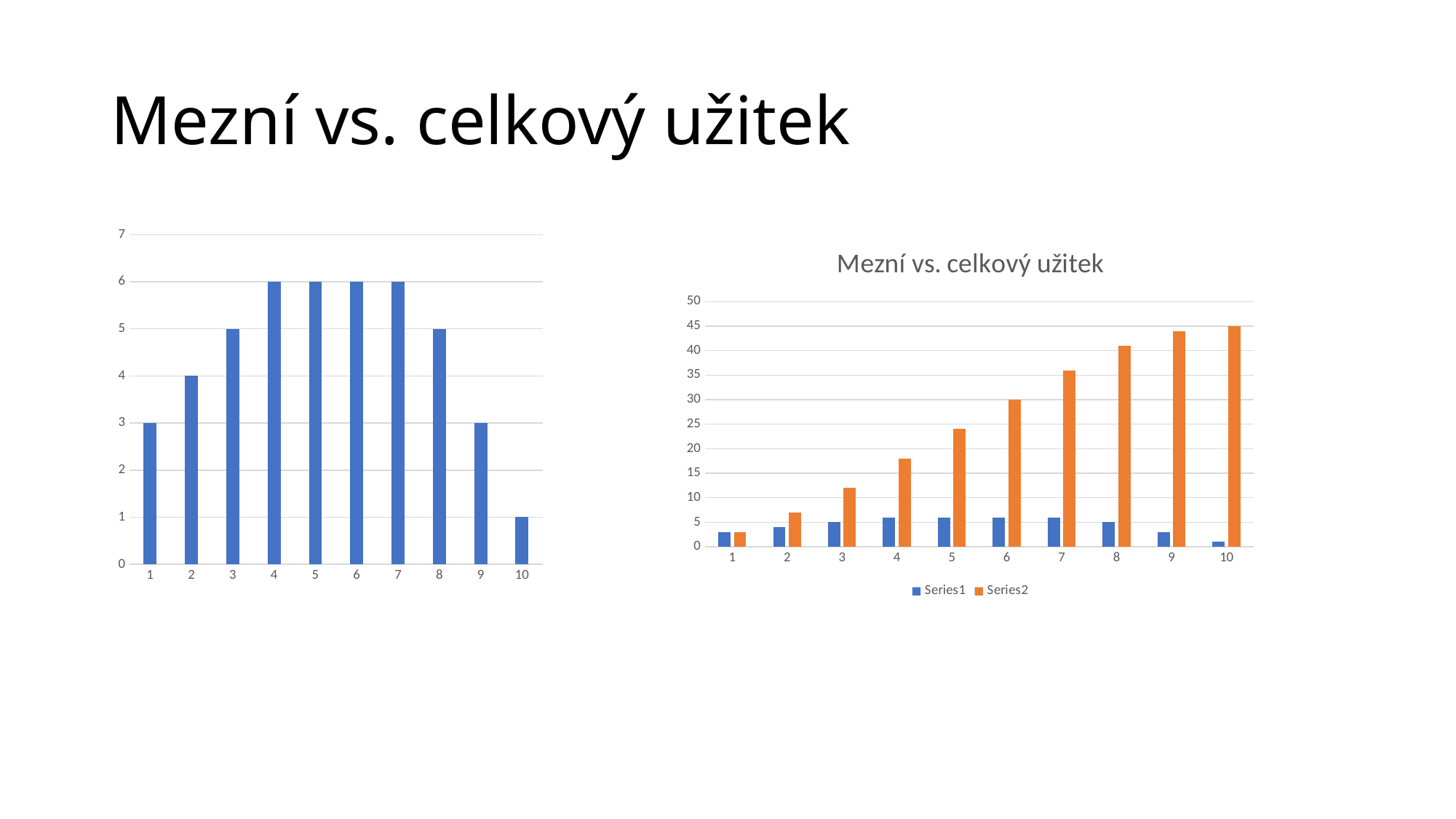
In the chart titled 'Mezní vs. celkový užitek', how many series does the legend list? 2 In the left chart, what is the difference between the value for category 1 and the value for category 10? 2 In the left chart, how many categories are shown on the x axis? 10 In the left chart, what is the value for category 4? 6 In the left chart, which category has the lowest value? 10 In the chart titled 'Mezní vs. celkový užitek', what is the Series2 value for category 6? 30 In the chart titled 'Mezní vs. celkový užitek', do the Series2 values rise or fall from category 1 to category 10? rise In the chart titled 'Mezní vs. celkový užitek', which series has the larger value for category 5, Series1 or Series2? Series2 In the chart titled 'Mezní vs. celkový užitek', what is the Series2 value for category 10? 45 What kind of chart is the left chart? bar chart In the left chart, what is the value for category 10? 1